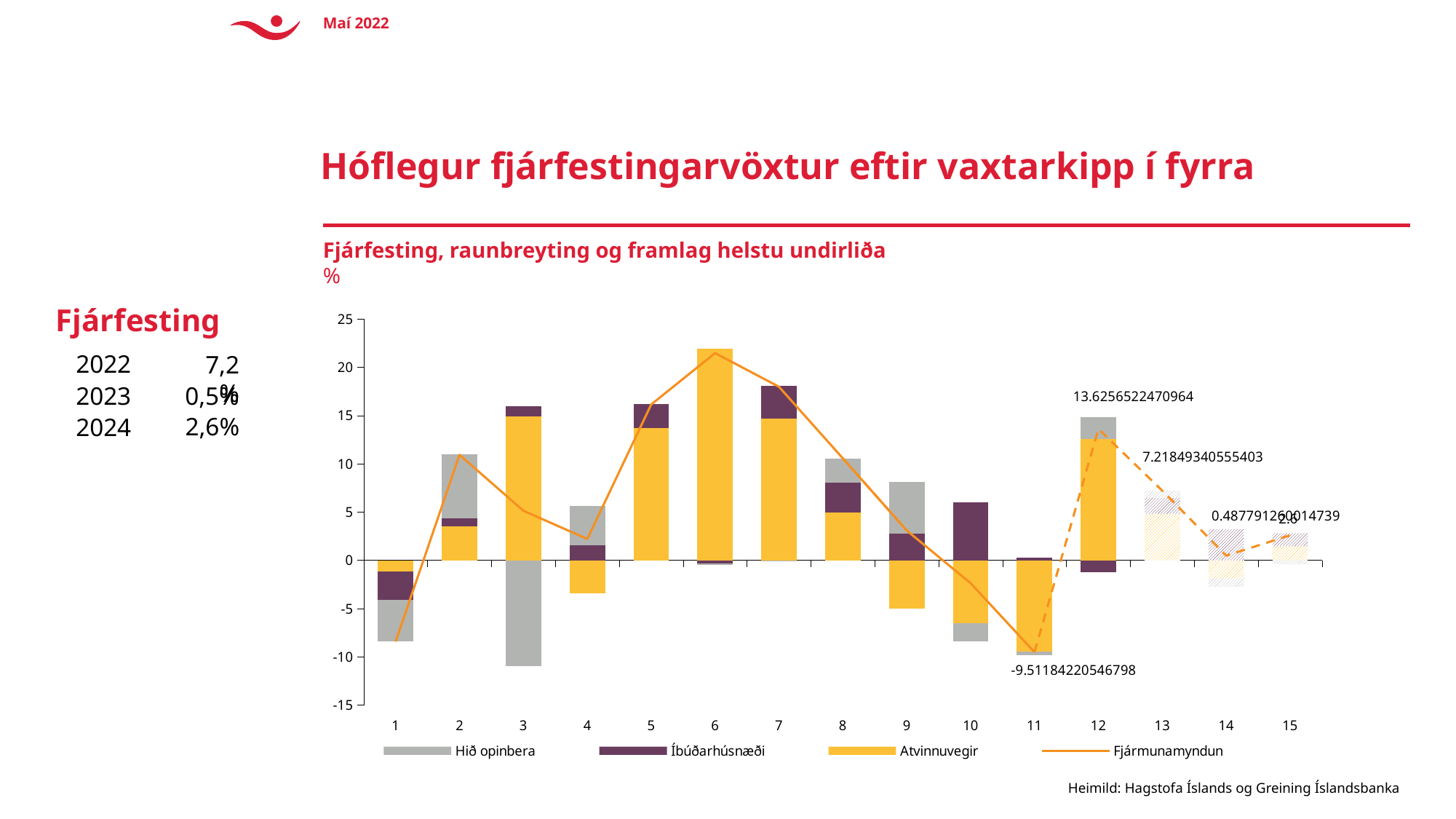
What is the value of the Fjármunamyndun line at category 12? 13.6256522470964 How many series does the chart legend list? 4 What is the title of the chart? Fjárfesting, raunbreyting og framlag helstu undirliða What is the difference between the Fjármunamyndun values at category 12 and category 13? 6.40715884154237 How many categories are shown on the x axis of the chart? 15 Does the Fjármunamyndun line rise or fall from category 12 to category 14? fall Is the value of the Fjármunamyndun line at category 6 greater or less than 20? greater What is the value of the Fjármunamyndun line at category 13? 7.21849340555403 Which is larger, the Fjármunamyndun value at category 12 or at category 13? category 12 What is the value of the Fjármunamyndun line at category 14? 0.487791260014739 At which category does the Fjármunamyndun line reach its highest value? 6 What is the value of the Fjármunamyndun line at category 11? -9.51184220546798